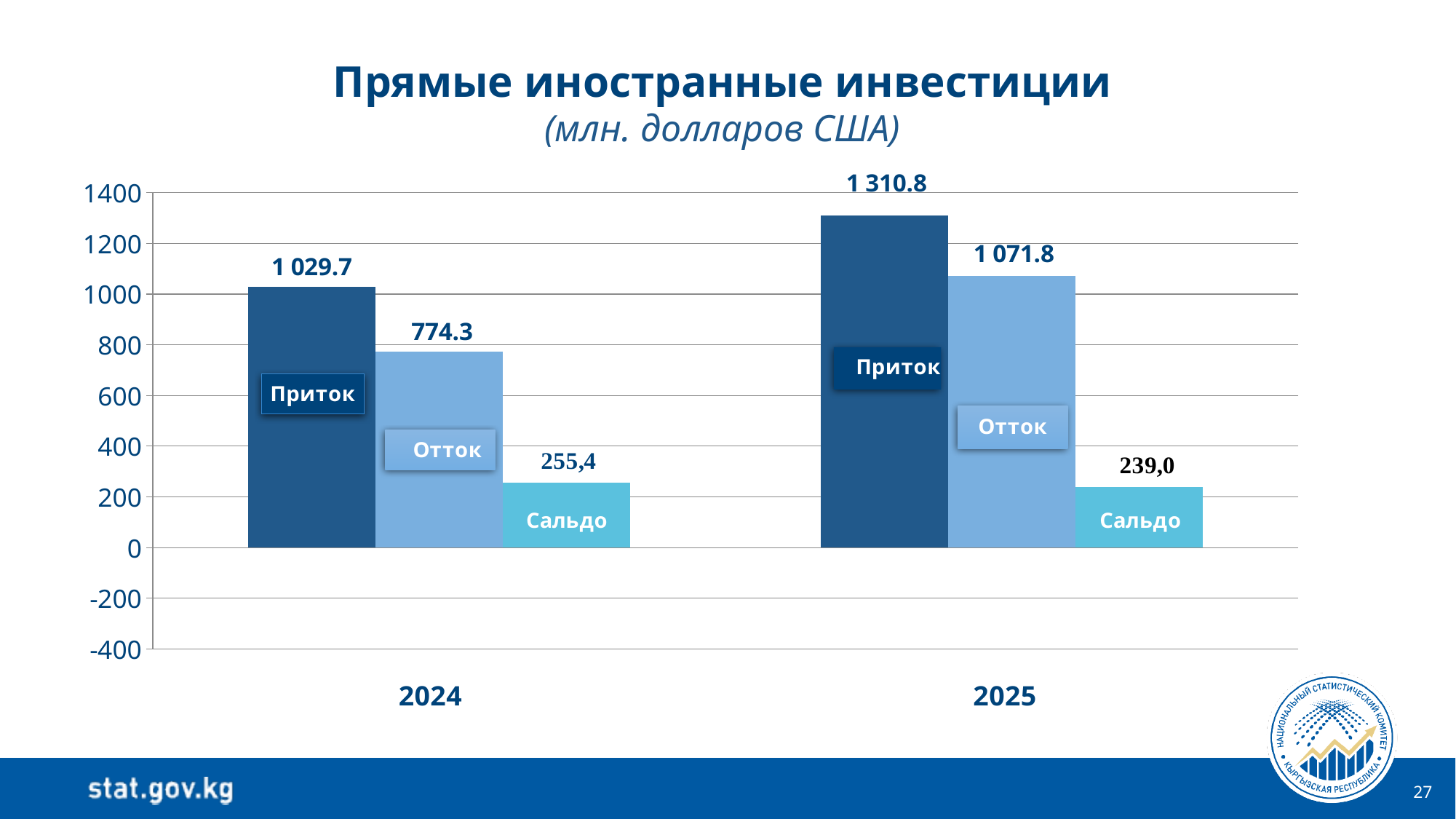
Which bar has the highest value on the chart? Приток 2025 How many years (categories) are shown on the x axis? 2 What is the value of Сальдо for 2025? 239,0 Which is larger: Отток in 2025 or Приток in 2024? Отток in 2025 By how much did Приток increase from 2024 to 2025? 281.1 Which bar has the lowest value on the chart? Сальдо 2025 What is the value of Приток for 2024? 1 029.7 What unit is given in the chart subtitle? млн. долларов США What is the value of Сальдо for 2024? 255,4 What is the difference between Отток in 2025 and Отток in 2024? 297.5 What type of chart is shown on the slide? bar chart What is the value of Отток for 2025? 1 071.8